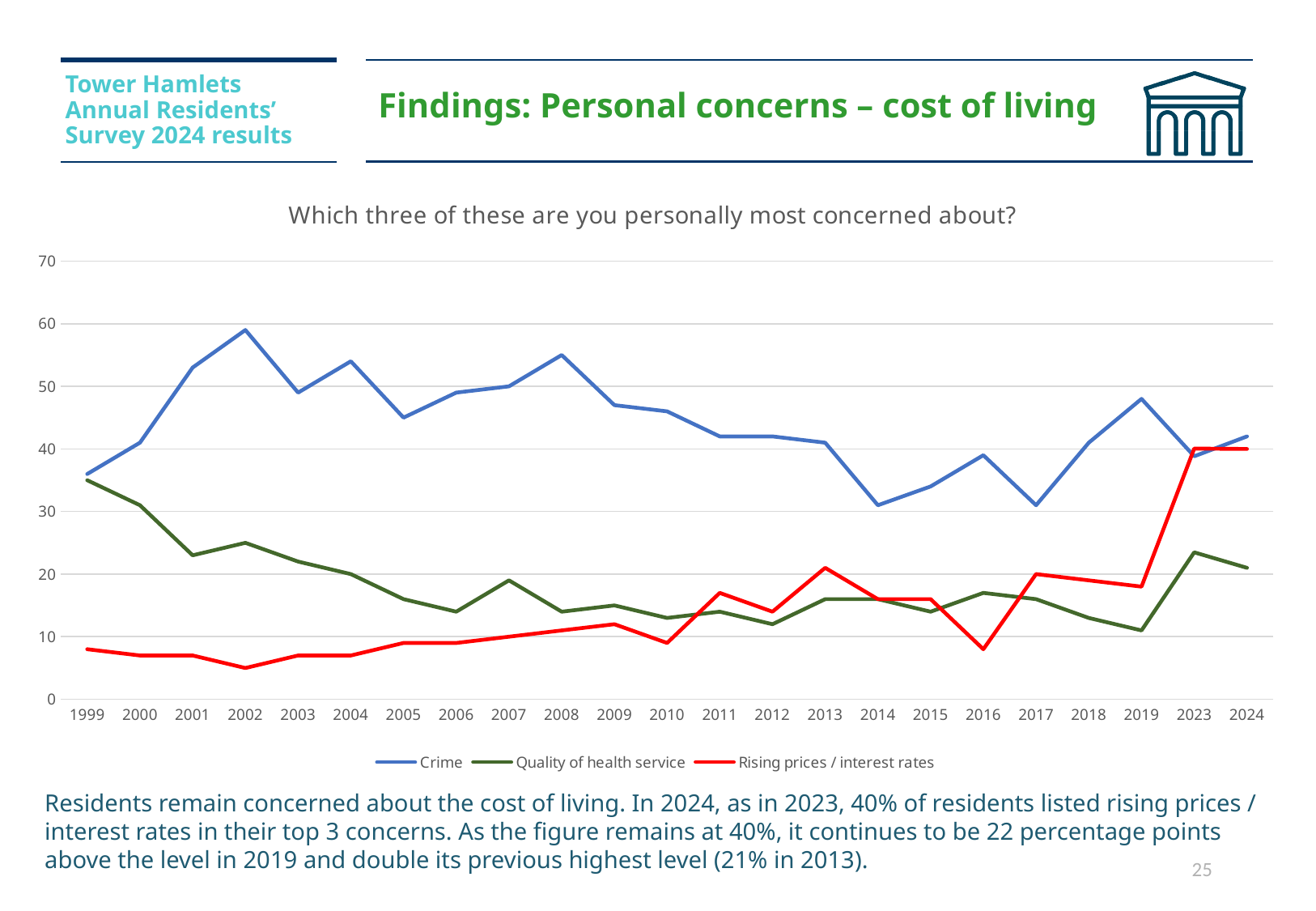
In 2024, which is larger: Crime or Quality of health service? Crime In which year is the Rising prices / interest rates line at its lowest? 2002 Is the value for Rising prices / interest rates in 2016 greater or less than 10? less Is the value for Crime in 2002 greater or less than 50? greater What percentage of residents listed rising prices / interest rates in their top 3 concerns in 2024? 40% Does the Quality of health service line rise or fall from 1999 to 2006? Fall Is the value for Quality of health service in 2019 greater or less than 20? less How many years are shown along the x axis? 23 How many series does the legend list? 3 What was the previous highest level for rising prices / interest rates, reached in 2013? 21% In which year does the Crime line reach its highest value? 2002 What kind of chart is shown on the slide? Line chart